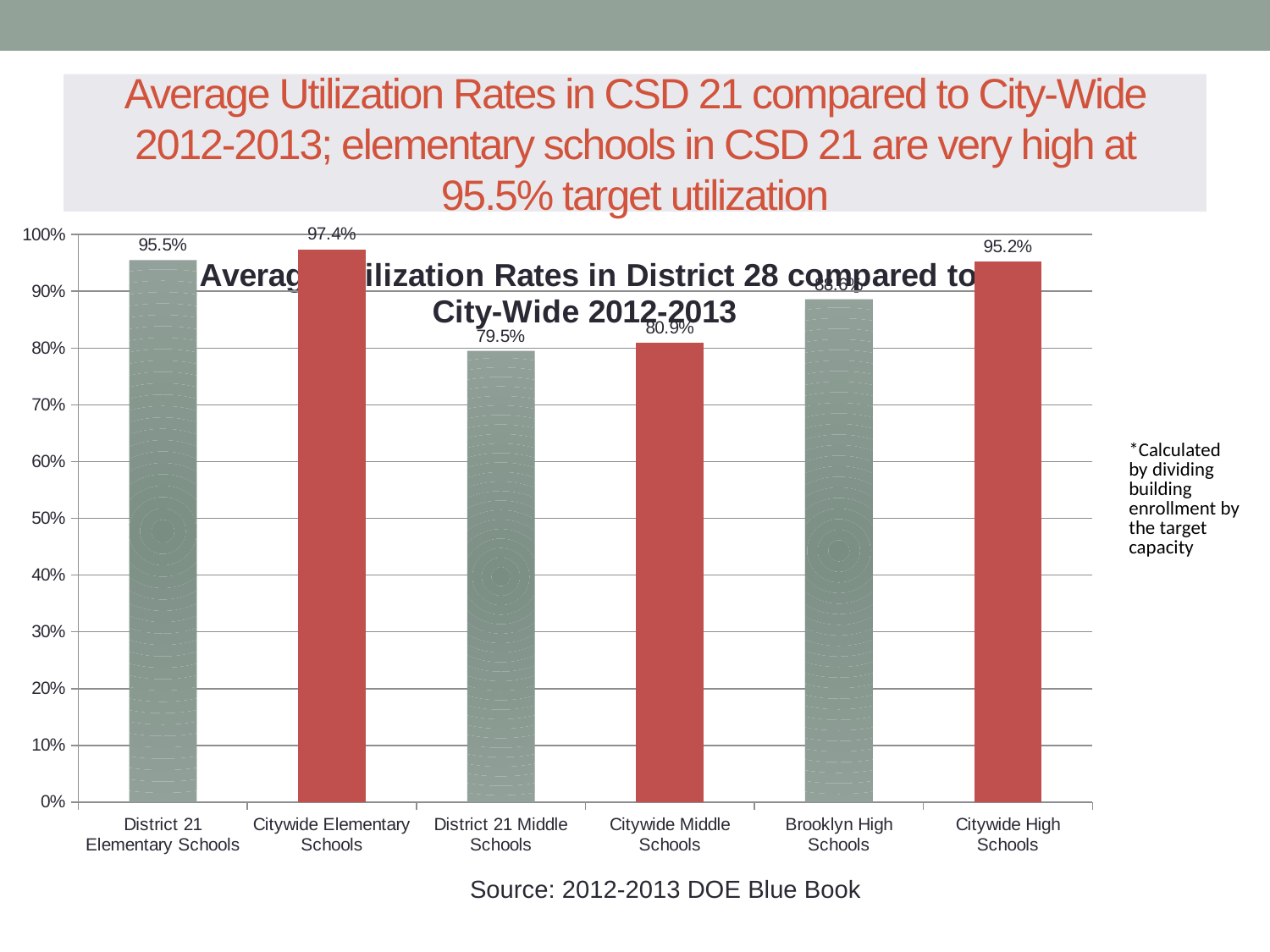
What is the difference between the utilization rates of Citywide Elementary Schools and District 21 Elementary Schools? 1.9 percentage points What is the average utilization rate for Citywide Elementary Schools? 97.4% Which category has the highest utilization rate? Citywide Elementary Schools What is the average utilization rate for Citywide Middle Schools? 80.9% Is the value for Brooklyn High Schools greater or less than 80%? greater What is the average utilization rate for District 21 Middle Schools? 79.5% What is the average utilization rate for District 21 Elementary Schools? 95.5% How many categories are shown on the x axis of the chart? 6 What is the average utilization rate for Citywide High Schools? 95.2% Which category has the lowest utilization rate? District 21 Middle Schools What kind of chart is shown on the slide? bar chart Which has a higher utilization rate, District 21 Middle Schools or Citywide Middle Schools? Citywide Middle Schools